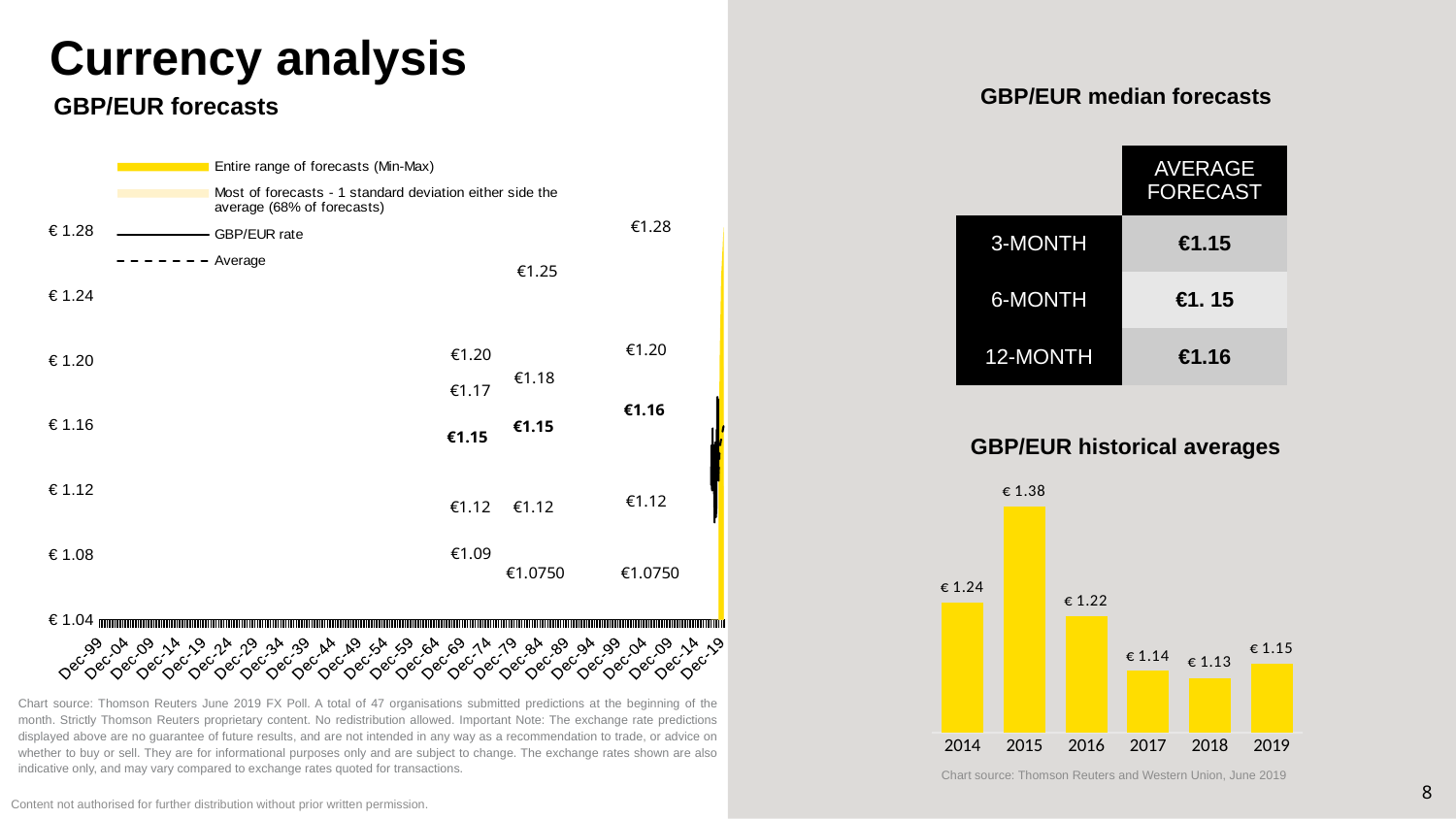
In the GBP/EUR historical averages chart, what is the difference between the 2015 and 2014 values? € 0.14 In the GBP/EUR historical averages chart, what is the value for 2015? € 1.38 In the GBP/EUR historical averages chart, which is larger, the value for 2016 or the value for 2017? 2016 What is the highest value shown on the y axis of the GBP/EUR forecasts chart? € 1.28 What kind of chart is the GBP/EUR historical averages chart? Bar chart In the GBP/EUR historical averages chart, which year has the lowest value? 2018 In the GBP/EUR historical averages chart, do the values rise or fall from 2015 to 2018? Fall How many years are shown in the GBP/EUR historical averages chart? 6 How many entries does the legend of the GBP/EUR forecasts chart list? 4 In the GBP/EUR historical averages chart, which year has the highest value? 2015 In the GBP/EUR historical averages chart, what is the value for 2019? € 1.15 In the GBP/EUR historical averages chart, what is the value for 2018? € 1.13